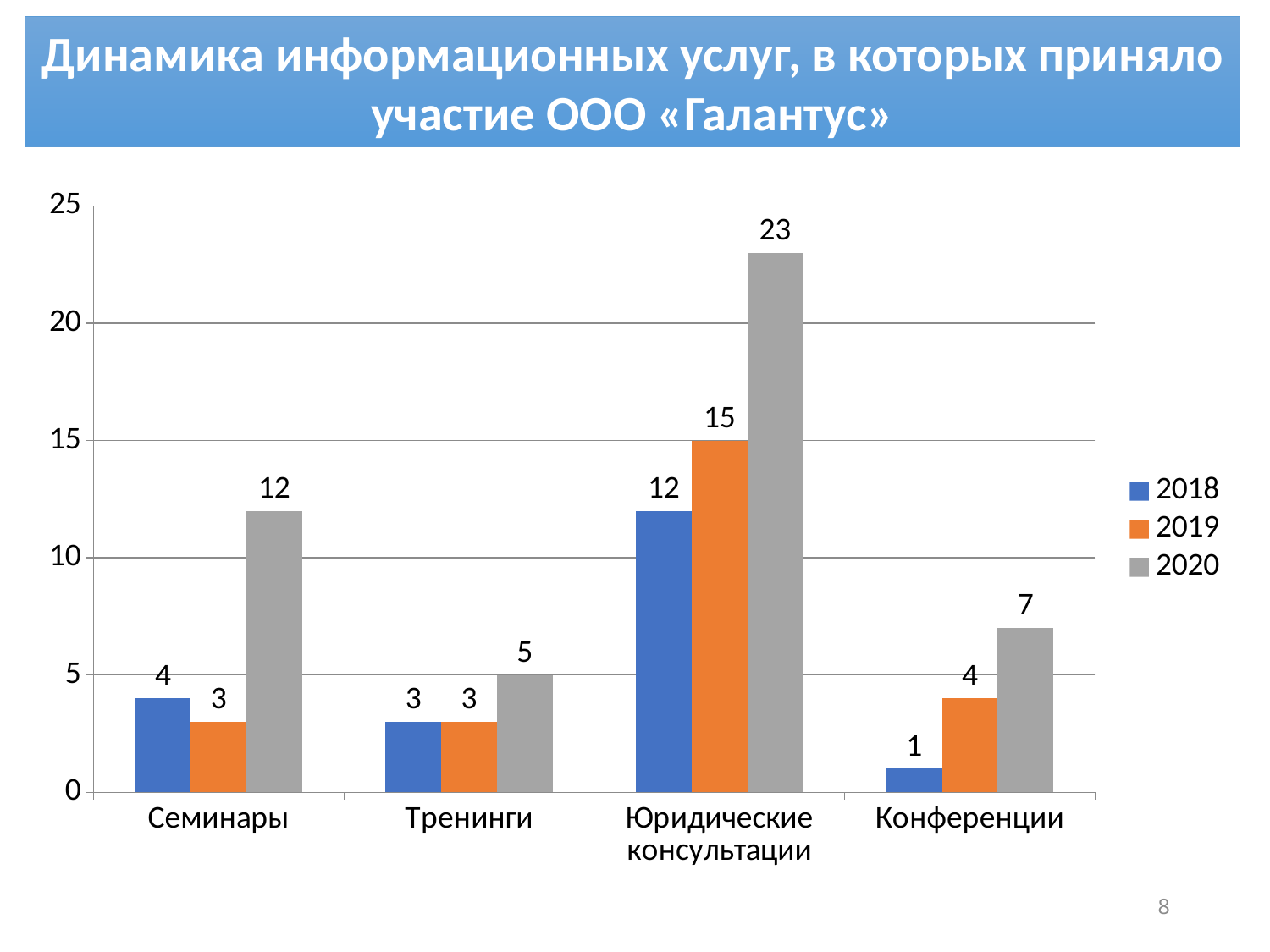
What is the difference between the 2020 and 2019 values for Юридические консультации? 8 What is the difference between the 2020 and 2018 values for Семинары? 8 Which is larger: the 2020 value for Семинары or the 2020 value for Конференции? Семинары Which category has the highest value in 2020? Юридические консультации Do the values for Конференции rise or fall from 2018 to 2020? Rise What is the value for Семинары in 2018? 4 How many categories are shown on the x axis? 4 Which category has the lowest value in 2018? Конференции What is the value for Юридические консультации in 2020? 23 What kind of chart is shown on the slide? Bar chart What is the value for Конференции in 2019? 4 How many series does the legend list? 3